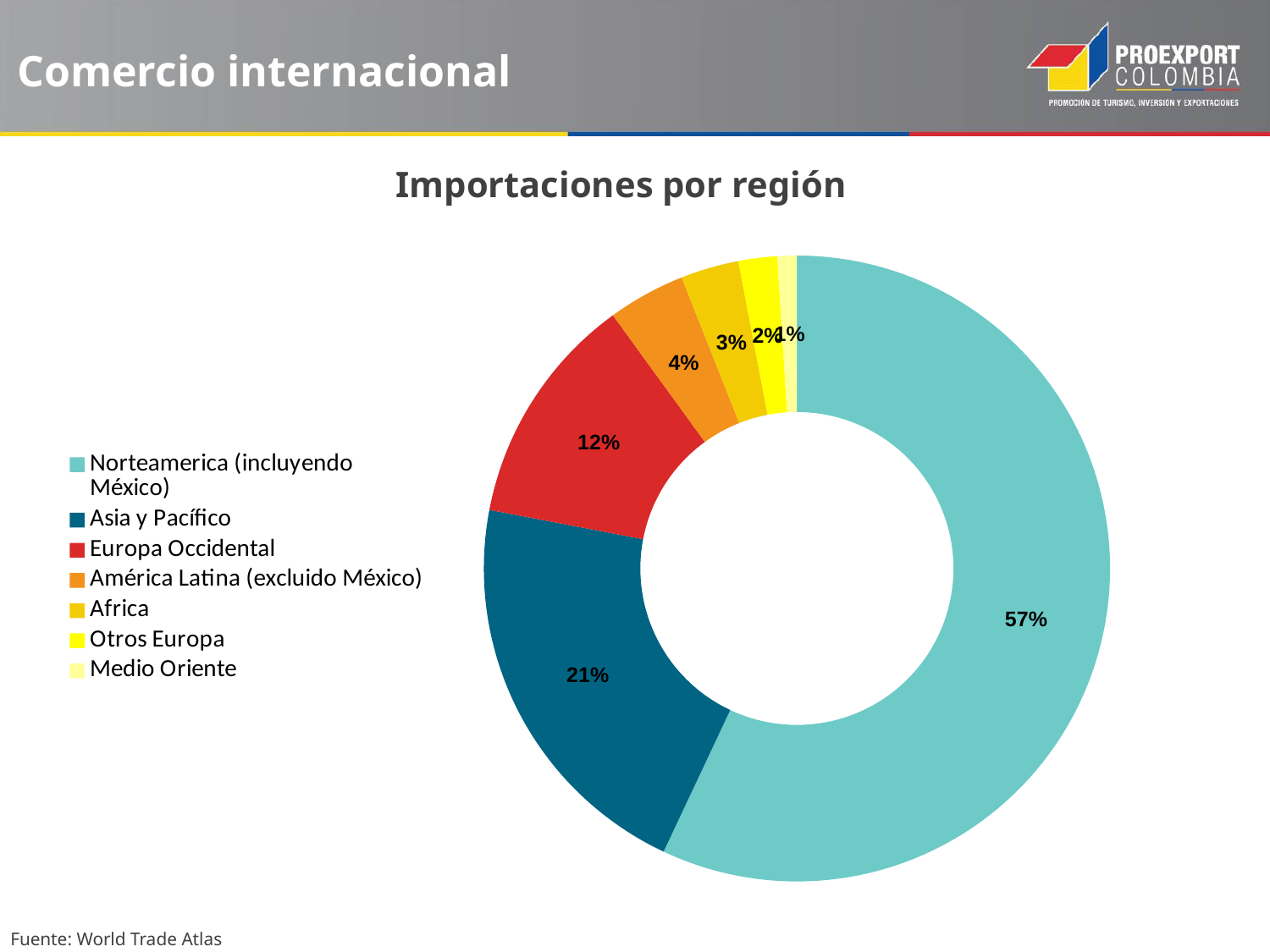
What share of imports comes from Norteamerica (incluyendo México)? 57% Which has a larger share of imports, Europa Occidental or América Latina (excluido México)? Europa Occidental How many regions are listed in the legend? 7 What share of imports comes from Asia y Pacífico? 21% Which region has the largest share of imports? Norteamerica (incluyendo México) What is the difference in percentage points between the shares of Norteamerica (incluyendo México) and Asia y Pacífico? 36 percentage points What kind of chart is shown on the slide? Doughnut (pie) chart Which region has the smallest share of imports? Medio Oriente What is the title of the chart? Importaciones por región What share of imports comes from Africa? 3%